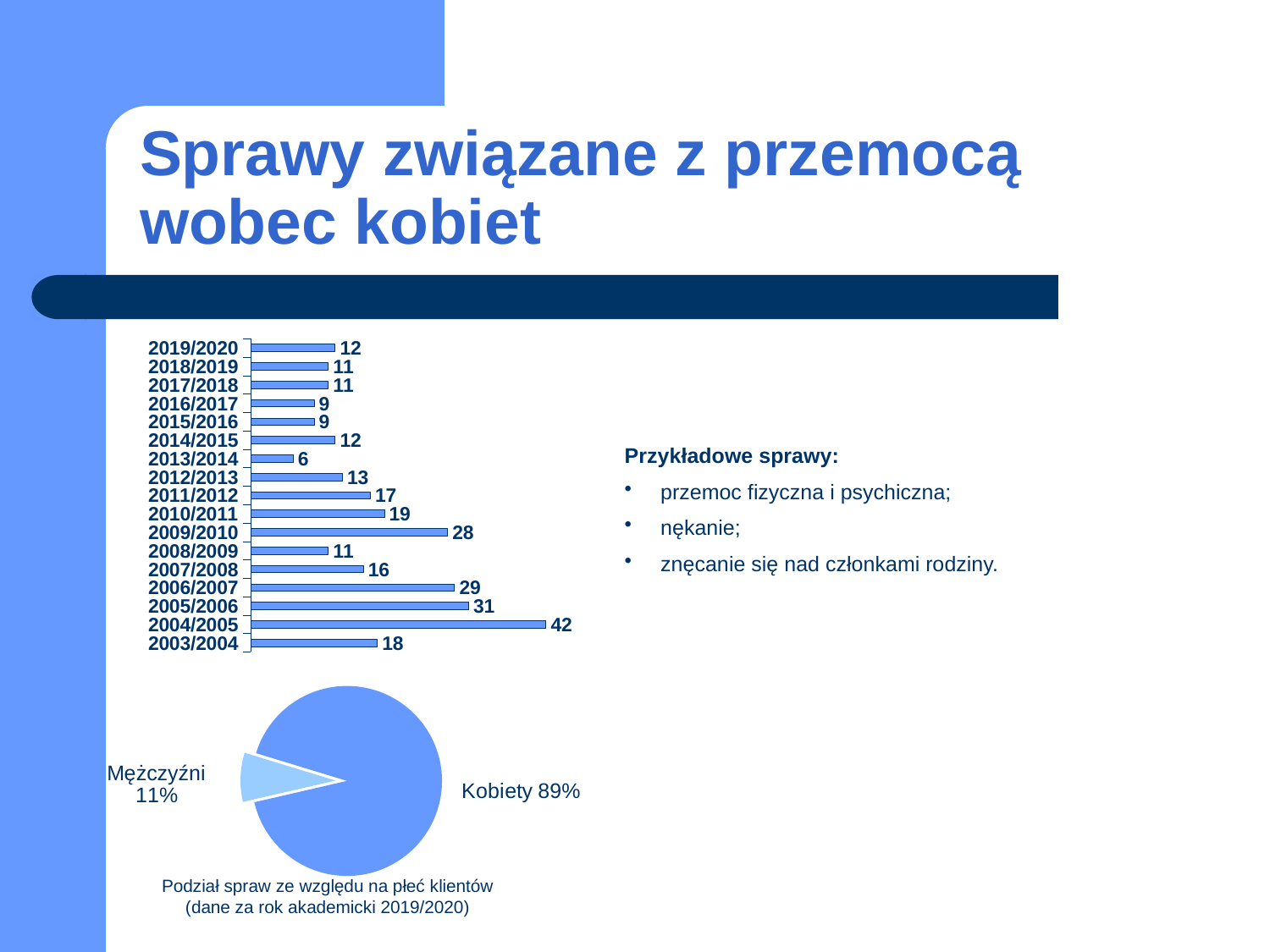
In the bar chart at the top left, which academic year has the lowest value? 2013/2014 In the bar chart at the top left, what is the difference between the values for 2005/2006 and 2006/2007? 2 What kind of chart is the chart at the bottom left of the slide? pie chart In the pie chart at the bottom left, what share is labelled Mężczyźni? 11% In the bar chart at the top left, what is the value for 2009/2010? 28 In the bar chart at the top left, what is the value for 2004/2005? 42 In the bar chart at the top left, which academic year has the highest value? 2004/2005 What kind of chart is the chart at the top left of the slide? bar chart In the bar chart at the top left, what is the value for 2019/2020? 12 How many academic years are shown in the bar chart at the top left? 17 In the bar chart at the top left, which is larger, the value for 2010/2011 or the value for 2011/2012? 2010/2011 In the pie chart at the bottom left, what share is labelled Kobiety? 89%